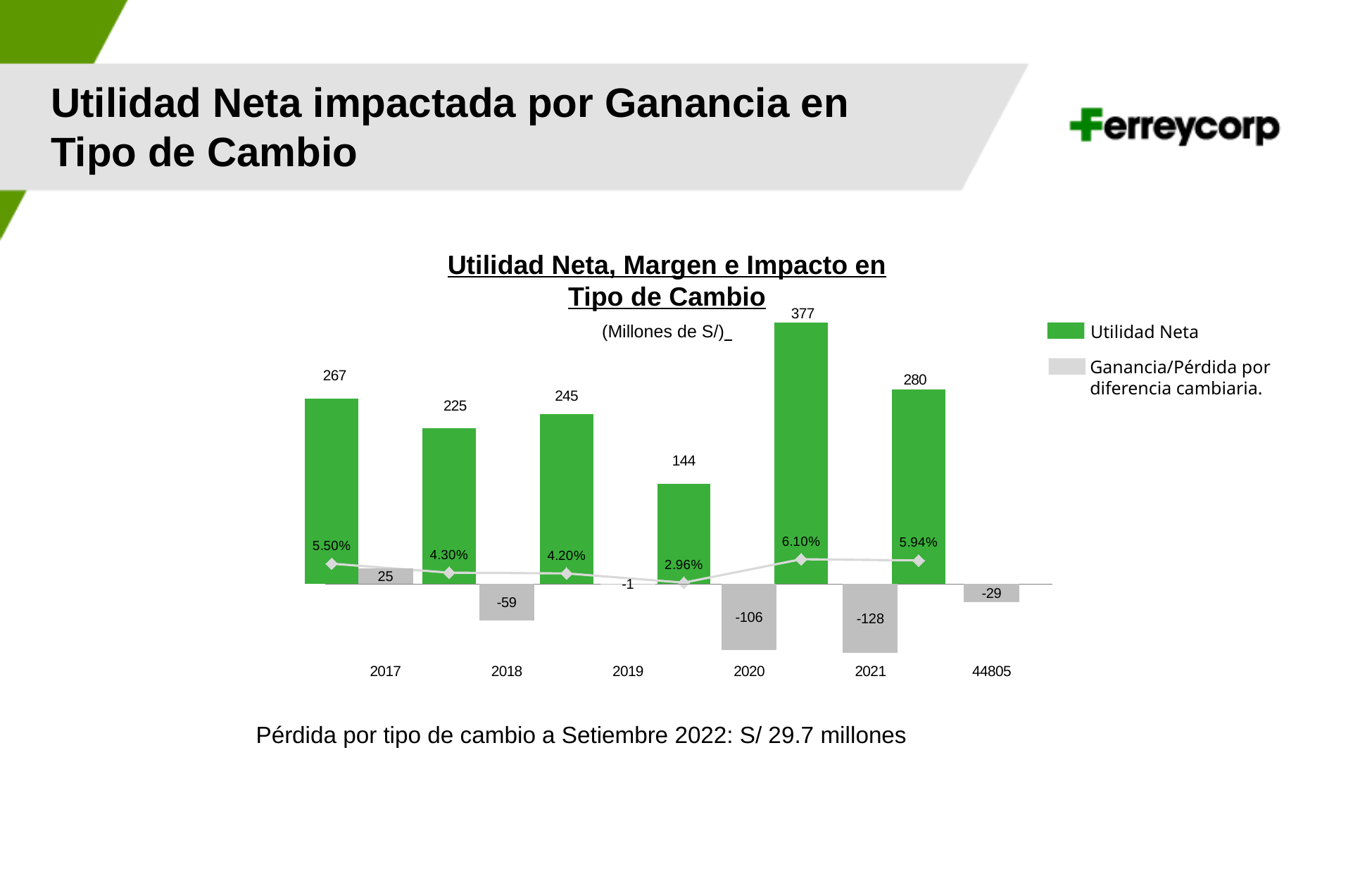
Which year has the lowest Utilidad Neta? 2020 What is the difference between the Utilidad Neta for 2021 and 2020? 233 Which year has the larger Utilidad Neta, 2018 or 2019? 2019 What kind of chart is shown on the slide? combination bar and line chart What is the Ganancia/Pérdida por diferencia cambiaria value for 2021? -128 How many series does the legend list? 2 What is the Ganancia/Pérdida por diferencia cambiaria value for 2017? 25 How many categories are shown on the x axis? 6 Which year has the highest Utilidad Neta? 2021 Does the margin percentage rise or fall from 2017 to 2020? fall What margin percentage is shown for 2020? 2.96% What is the Utilidad Neta value for 2020? 144